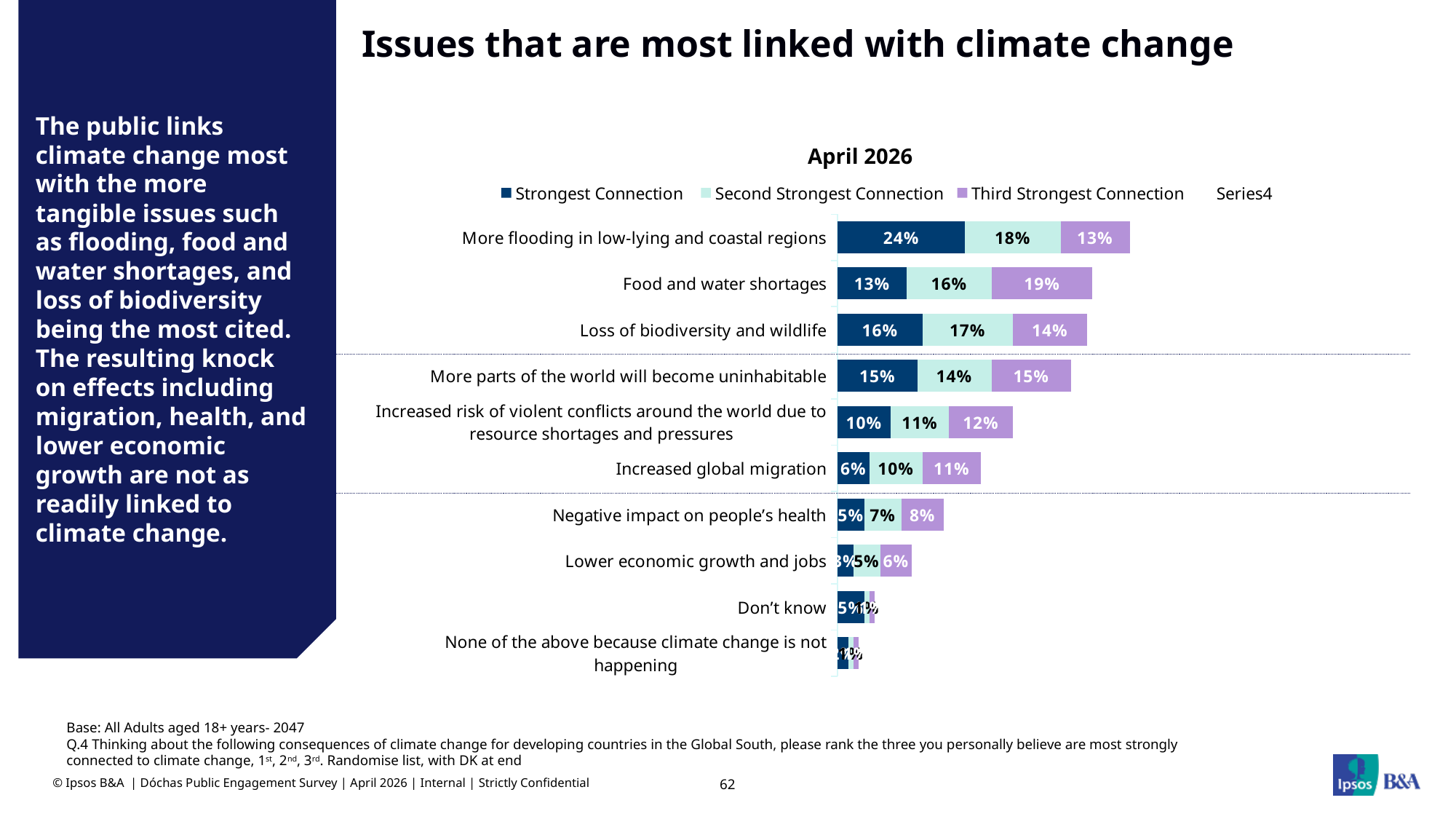
What is the Third Strongest Connection value for "Food and water shortages"? 19% What is the total of the stacked bar for "Increased global migration"? 27% What kind of chart is shown on the slide? stacked bar chart What is the total of the stacked bar for "More flooding in low-lying and coastal regions"? 55% How many series does the legend list? 4 What is the difference between the Strongest Connection values for "More flooding in low-lying and coastal regions" and "Food and water shortages"? 11% Which is larger: the Strongest Connection value for "Loss of biodiversity and wildlife" or for "Increased global migration"? Loss of biodiversity and wildlife What is the Strongest Connection value for "More flooding in low-lying and coastal regions"? 24% What is the title of the chart? April 2026 What is the Second Strongest Connection value for "Loss of biodiversity and wildlife"? 17% How many categories are shown on the chart? 10 Which category has the highest Strongest Connection value? More flooding in low-lying and coastal regions